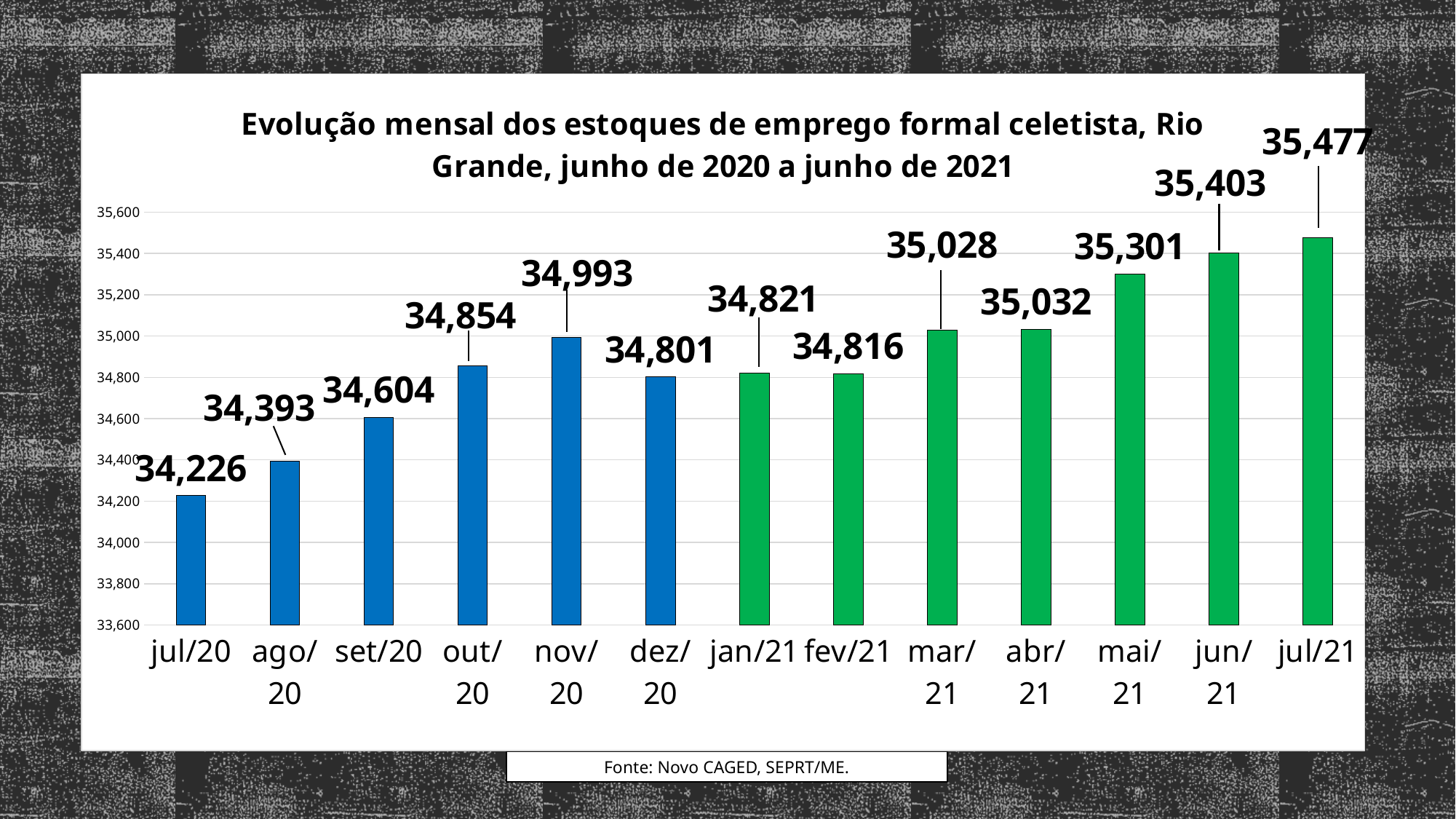
What is the difference between the values for jul/21 and jul/20? 1,251 Which is larger, the value for nov/20 or the value for jan/21? nov/20 What is the value for mar/21? 35,028 Which month has the highest value? jul/21 What kind of chart is this? bar chart What colour are the bars for the 2021 months? green Which month has the lowest value? jul/20 How many months are shown on the x axis? 13 What is the value for nov/20? 34,993 What is the value for jul/20? 34,226 Do the values generally rise or fall from jul/20 to jul/21? rise What is the difference between the values for nov/20 and dez/20? 192